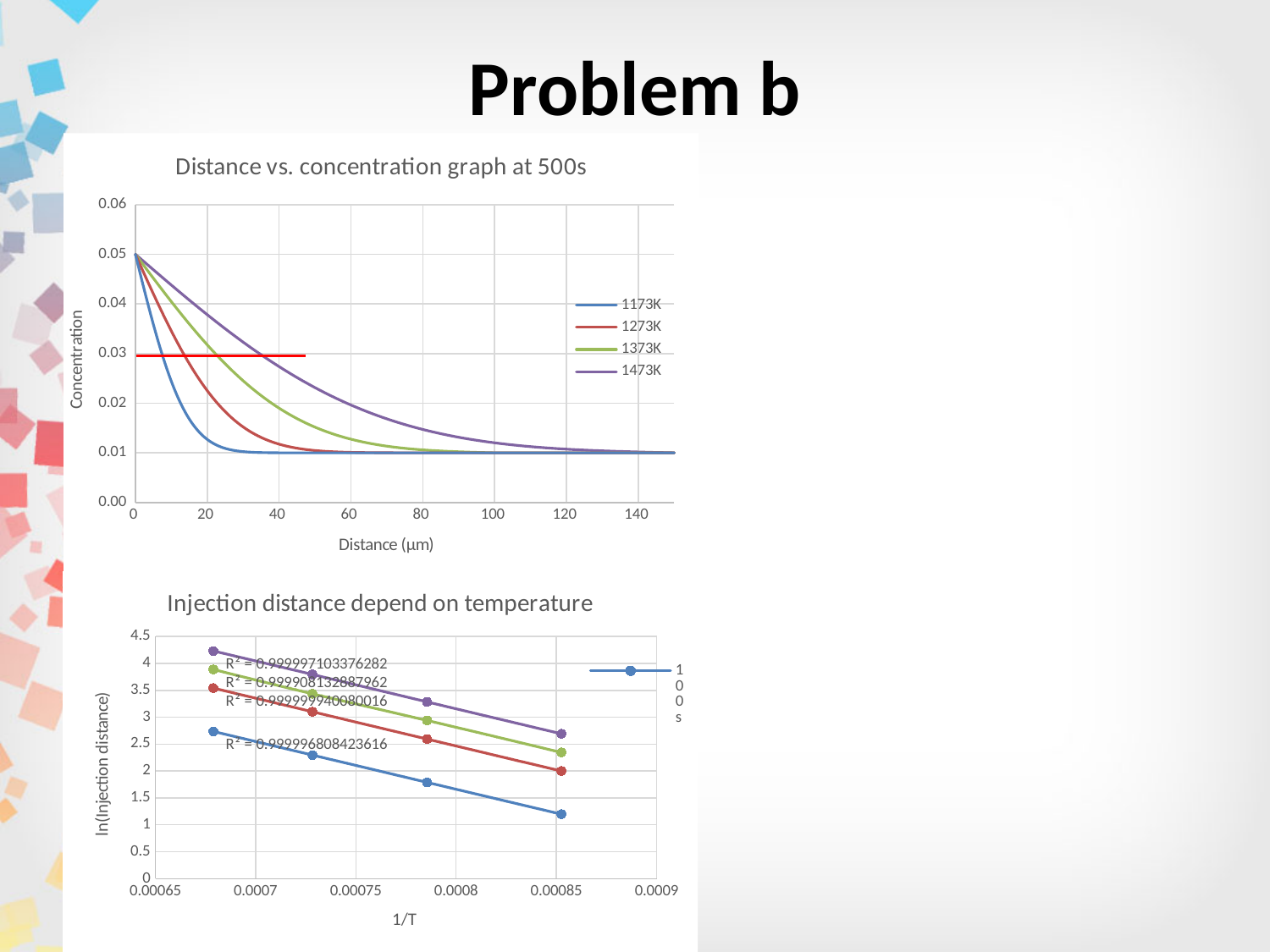
In the bottom chart 'Injection distance depend on temperature', how many data points does each series have? 4 In the top chart 'Distance vs. concentration graph at 500s', is the concentration for 1473K at a distance of 20 µm greater or less than 0.03? greater What kind of chart is the top chart titled 'Distance vs. concentration graph at 500s'? line chart In the bottom chart 'Injection distance depend on temperature', do the ln(Injection distance) values rise or fall as 1/T increases? fall In the top chart 'Distance vs. concentration graph at 500s', at a distance of 40 µm, which series has the higher concentration, 1473K or 1173K? 1473K In the top chart 'Distance vs. concentration graph at 500s', which series drops to the baseline concentration at the shortest distance? 1173K In the bottom chart 'Injection distance depend on temperature', is the value of the lowest (blue) series at 1/T = 0.00085 greater or less than 1.5? less In the top chart 'Distance vs. concentration graph at 500s', which series keeps its concentration above the baseline out to the largest distance? 1473K In the top chart 'Distance vs. concentration graph at 500s', how many series does the legend list? 4 In the top chart 'Distance vs. concentration graph at 500s', do the concentration values rise or fall as distance increases? fall In the top chart 'Distance vs. concentration graph at 500s', is the concentration for 1173K at a distance of 40 µm greater or less than 0.02? less In the top chart 'Distance vs. concentration graph at 500s', what are the legend entries? 1173K, 1273K, 1373K, 1473K